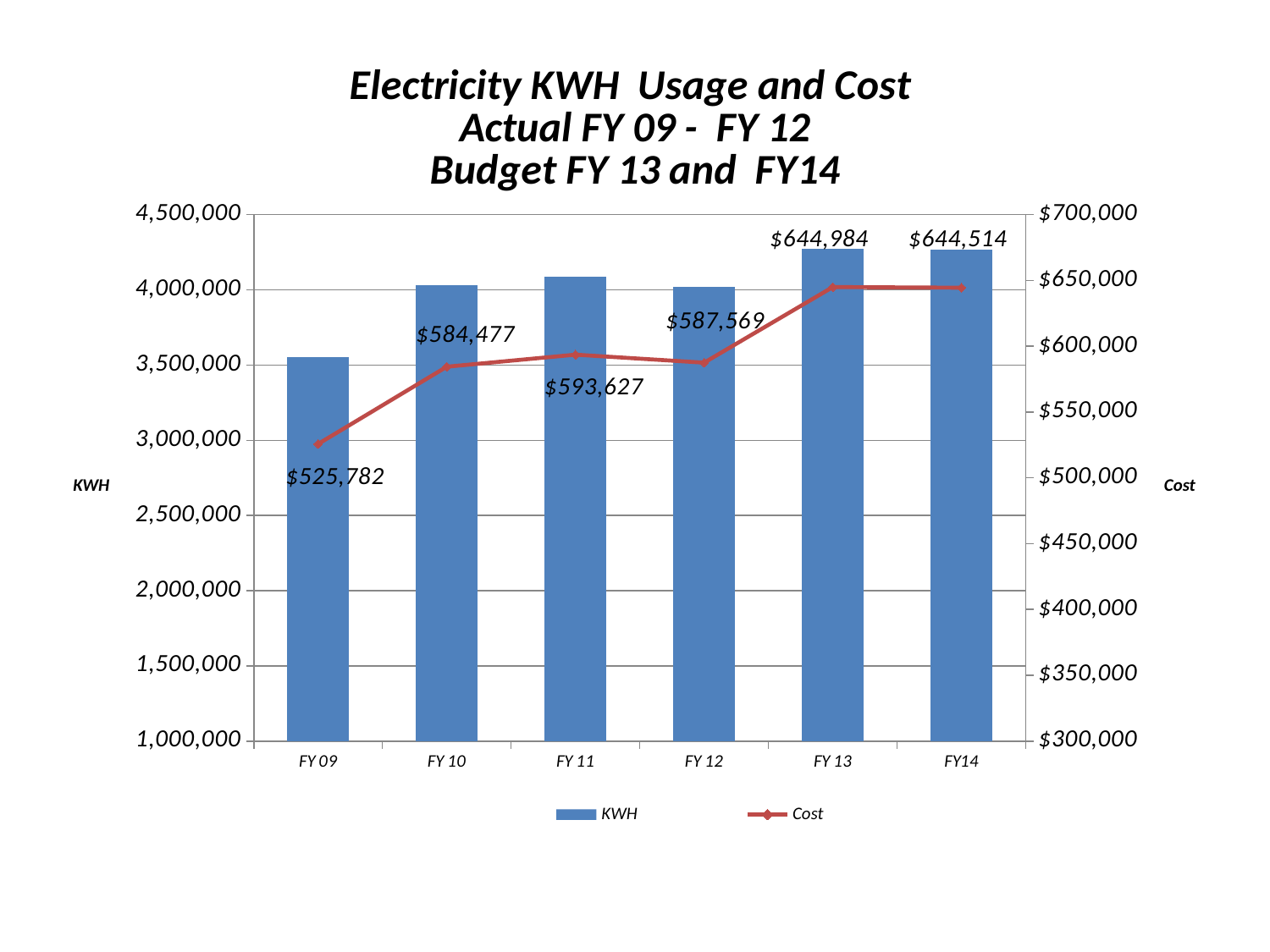
Is the KWH value for FY 09 greater or less than 4,000,000? less What is the difference between the Cost for FY 11 and the Cost for FY 10? $9,150 What is the Cost value for FY 09? $525,782 What is the Cost value for FY 11? $593,627 Which fiscal year has the lowest Cost value? FY 09 Which fiscal year has the highest Cost value? FY 13 Is the KWH value for FY 13 greater or less than 4,000,000? greater What is the difference between the Cost for FY 13 and the Cost for FY 09? $119,202 What is the Cost value for FY 13? $644,984 Which has the larger Cost value, FY 11 or FY 12? FY 11 How many fiscal years are shown on the x axis? 6 How many series does the legend list? 2